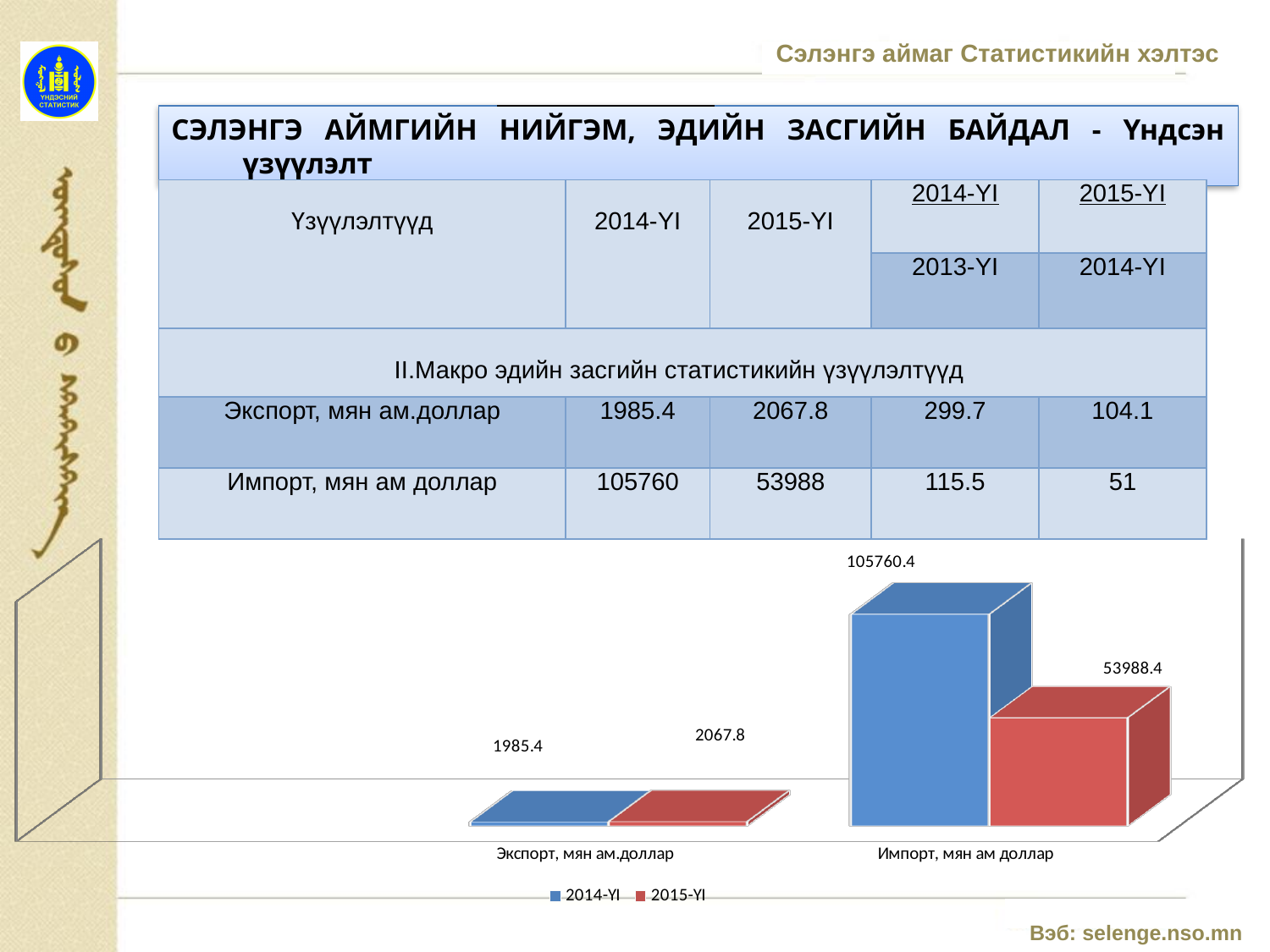
What is the 2015-YI value for Экспорт, мян ам.доллар in the chart? 2067.8 What is the 2015-YI value for Импорт, мян ам доллар in the chart? 53988.4 What is the difference between the 2014-YI and 2015-YI values for Импорт, мян ам доллар in the chart? 51772 Which colour represents the 2015-YI series in the chart? red Which category has the highest 2014-YI value in the chart? Импорт, мян ам доллар What type of chart is shown on the slide? bar chart How many series does the chart legend list? 2 For Экспорт, мян ам.доллар, which series has the larger value in the chart, 2014-YI or 2015-YI? 2015-YI What is the 2014-YI value for Импорт, мян ам доллар in the chart? 105760.4 How many categories are shown on the chart's x axis? 2 Which category has the lowest 2015-YI value in the chart? Экспорт, мян ам.доллар What is the 2014-YI value for Экспорт, мян ам.доллар in the chart? 1985.4